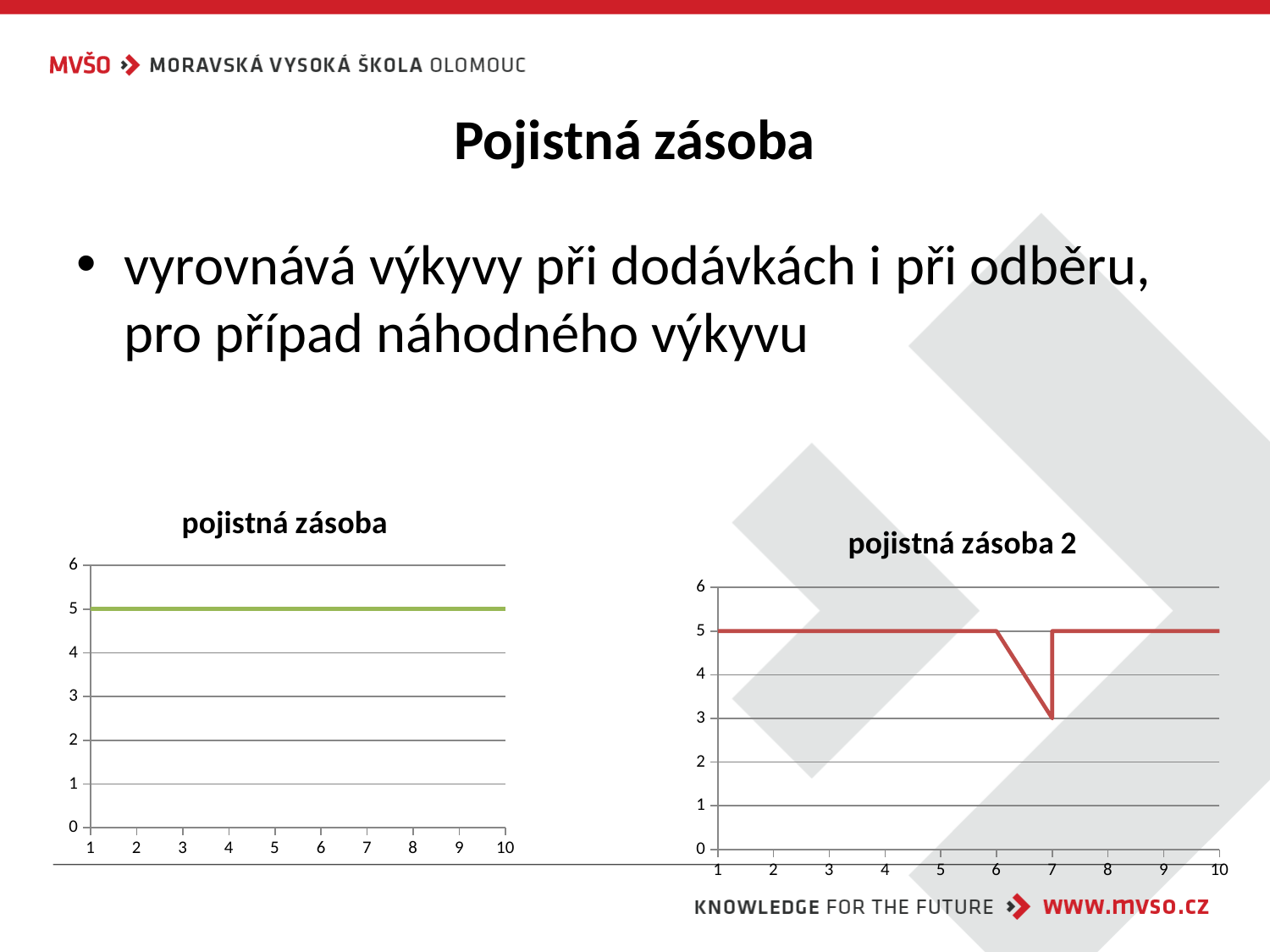
What is the maximum value shown on the y axis of the chart titled "pojistná zásoba"? 6 In the chart titled "pojistná zásoba 2", what is the value at x = 3? 5 In the chart titled "pojistná zásoba 2", what is the difference between the value at x = 5 and the lowest value at x = 7? 2 In the chart titled "pojistná zásoba", how many points are plotted along the x axis? 10 In the chart titled "pojistná zásoba", what is the value at x = 4? 5 In the chart titled "pojistná zásoba 2", is the value at x = 9 greater or less than 4? greater In the chart titled "pojistná zásoba 2", what is the lowest value the line reaches? 3 In the chart titled "pojistná zásoba", do the values rise, fall or stay flat along the x axis? stay flat What type of chart is the chart titled "pojistná zásoba 2" on the right? line chart In the chart titled "pojistná zásoba 2", at which x value does the line reach its lowest point? 7 What type of chart is the chart titled "pojistná zásoba" on the left? line chart In the chart titled "pojistná zásoba 2", which is larger: the value at x = 2 or the lowest value at x = 7? the value at x = 2